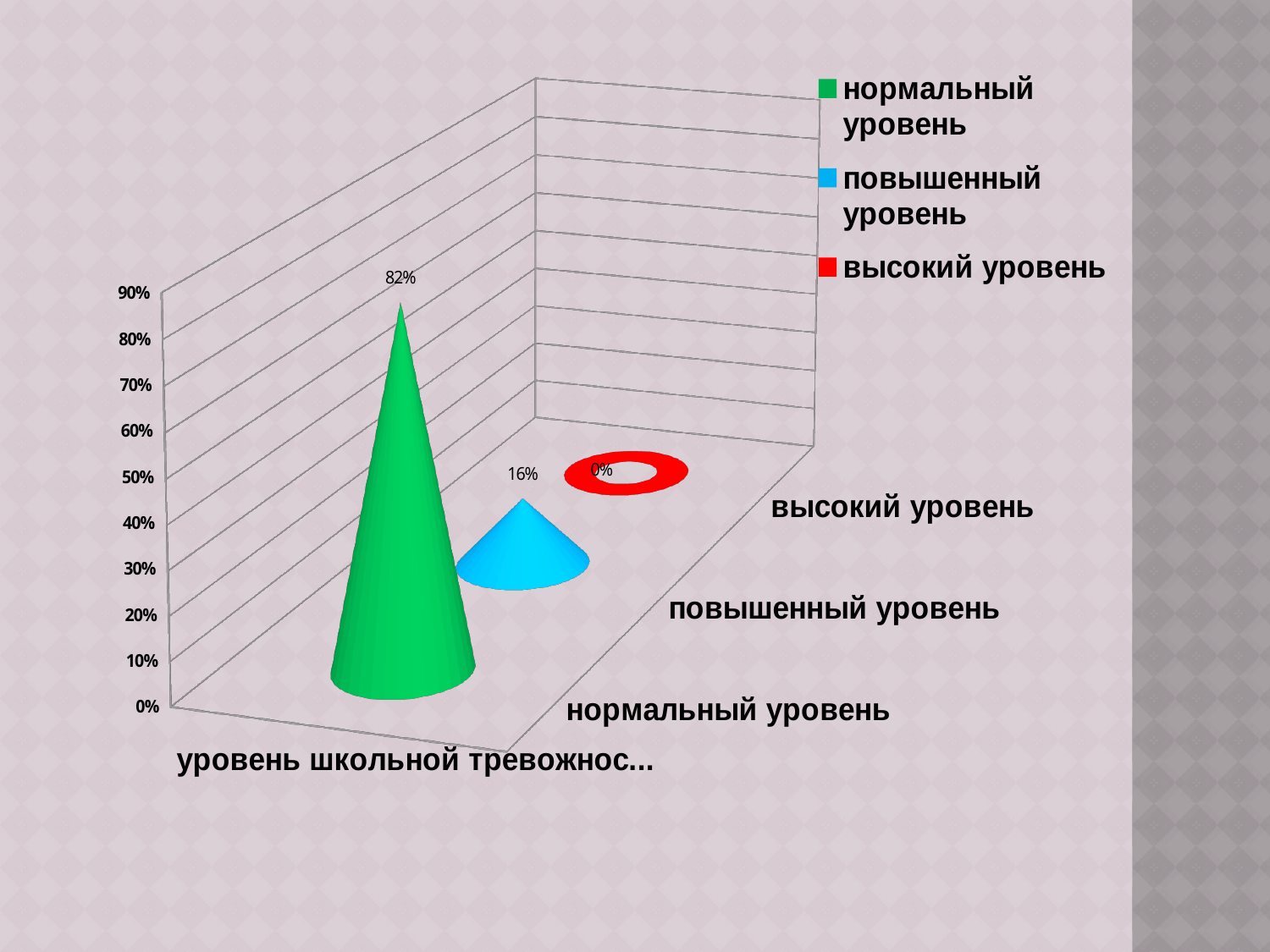
What is the value for нормальный уровень? 82% How many entries does the legend list? 3 How many categories are plotted on the chart? 3 Which category has the lowest value? высокий уровень What is the value for повышенный уровень? 16% What kind of chart is shown on the slide? bar chart Which category has the highest value? нормальный уровень What is the value for высокий уровень? 0% What colour represents высокий уровень in the legend? red What is the difference between the values for нормальный уровень and повышенный уровень? 66% Is the value for нормальный уровень greater or less than 50%? greater Which is larger, the value for повышенный уровень or the value for высокий уровень? повышенный уровень